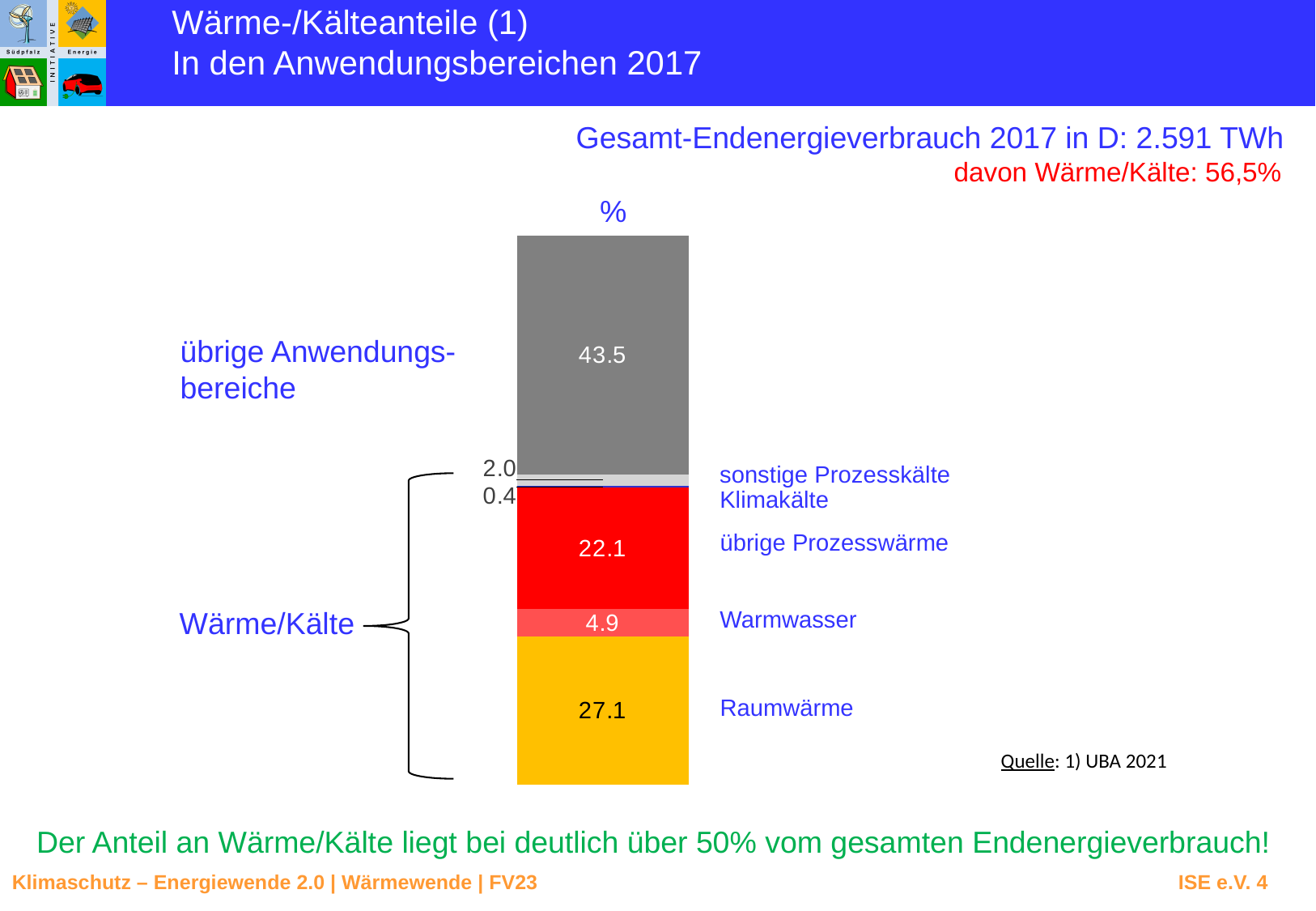
What is the value for übrige Prozesswärme? 22.1 What is the value for Raumwärme? 27.1 Which segment of the bar has the largest value? übrige Anwendungsbereiche How many segments does the stacked bar contain? 6 Which is larger, the value for Raumwärme or the value for übrige Prozesswärme? Raumwärme What is the value for Warmwasser? 4.9 Which segment of the bar has the smallest value? Klimakälte What is the total of the Wärme/Kälte segments (sonstige Prozesskälte, Klimakälte, übrige Prozesswärme, Warmwasser and Raumwärme)? 56.5 What is the value for sonstige Prozesskälte? 2.0 What is the value for Klimakälte? 0.4 What is the difference between the values for übrige Anwendungsbereiche and Raumwärme? 16.4 What kind of chart is shown on the slide? Stacked bar chart